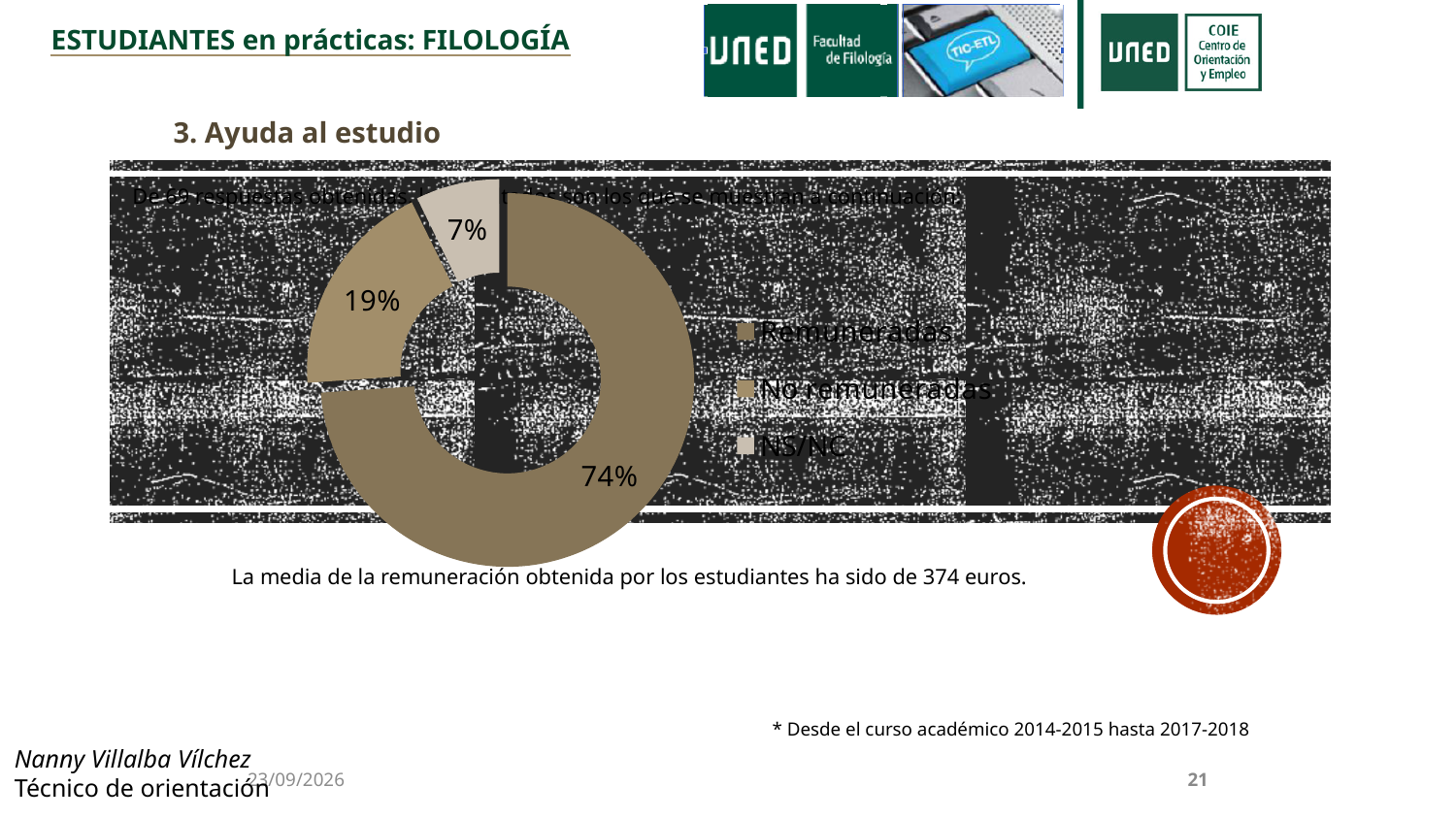
What kind of chart is shown on the slide? doughnut chart What is the difference in percentage points between the No remuneradas and NS/NC slices? 12 Which category has the smallest slice in the pie chart? NS/NC Which slice is larger, No remuneradas or NS/NC? No remuneradas What share of the pie chart corresponds to No remuneradas? 19% Which category has the largest slice in the pie chart? Remuneradas What are the three legend entries of the chart? Remuneradas, No remuneradas, NS/NC What share of the pie chart corresponds to NS/NC? 7% What share of the pie chart corresponds to Remuneradas? 74% How many categories does the pie chart show? 3 What is the difference in percentage points between the Remuneradas and No remuneradas slices? 55 Is the share for Remuneradas greater or less than 50%? greater